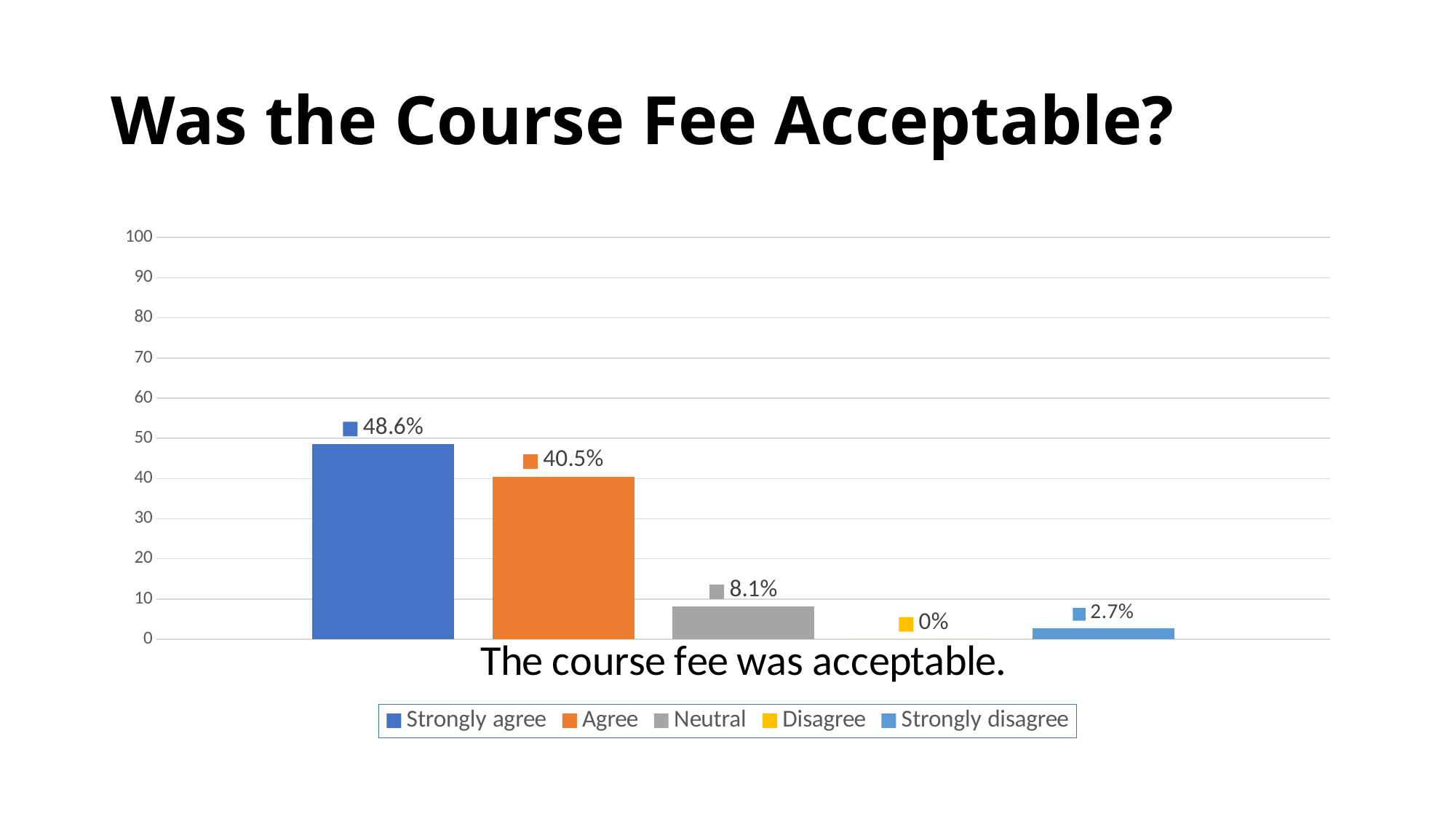
Which is larger, the percentage for Neutral or the percentage for Strongly disagree? Neutral What percentage of respondents selected Strongly agree? 48.6% What percentage of respondents selected Disagree? 0% What percentage of respondents selected Neutral? 8.1% What is the difference in percentage points between Strongly agree and Agree? 8.1 What percentage of respondents selected Strongly disagree? 2.7% What percentage of respondents selected Agree? 40.5% Which response option has the lowest percentage? Disagree How many series does the legend list? 5 What kind of chart is shown on the slide? Bar chart Which response option has the highest percentage? Strongly agree What is the category label shown beneath the bars? The course fee was acceptable.